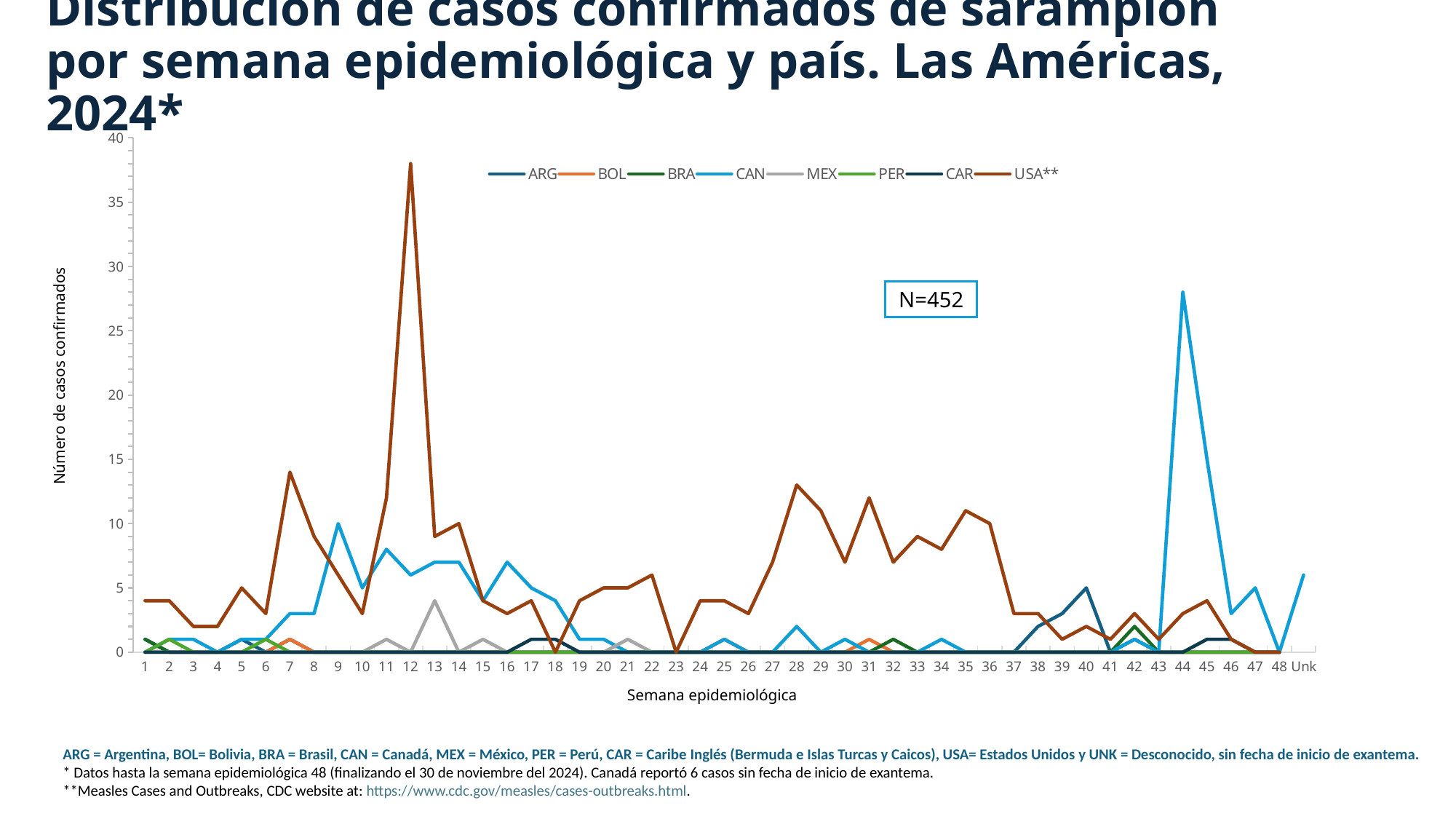
Is the USA** value in week 12 greater or less than 35? greater What kind of chart is shown on the slide? line chart Which is larger: the USA** peak in week 12 or the CAN peak in week 44? USA** peak in week 12 How many categories are shown on the x axis (epidemiological weeks plus Unk)? 49 Between week 9 and week 12, does the USA** line rise or fall? rise How many series does the legend list? 8 Is the CAN value in week 44 greater or less than 25? greater In which epidemiological week does the USA** series reach its peak? 12 Is the USA** value in week 7 greater or less than 10? greater Which series reaches the highest value on the chart? USA** In which epidemiological week does the CAN series reach its peak? 44 What total number of cases (N) is shown in the box on the chart? N=452